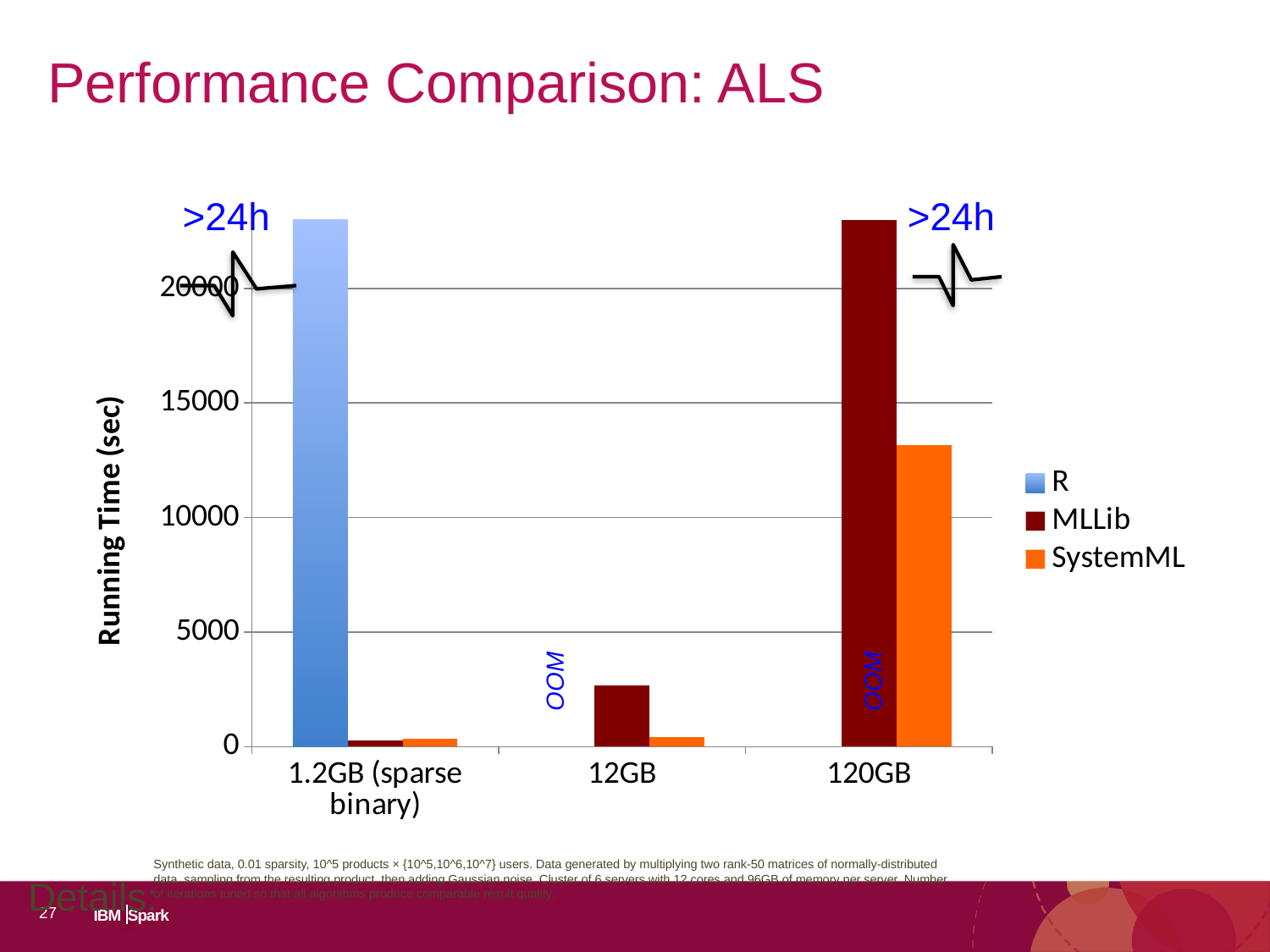
How many data-size categories are shown on the x axis? 3 Which series has the highest running time for the 1.2GB (sparse binary) dataset? R Is the SystemML running time for 120GB greater or less than 10000? greater Does the SystemML running time rise or fall as the dataset size increases from 1.2GB to 120GB? rise For the 12GB dataset, which has the larger running time, MLLib or SystemML? MLLib For the 120GB dataset, which has the larger running time, MLLib or SystemML? MLLib How many series does the legend list? 3 Is the SystemML running time for 120GB greater or less than 15000? less What are the three series listed in the legend? R, MLLib, SystemML What kind of chart is shown on the slide? bar chart What is the label of the y axis? Running Time (sec) Is the MLLib running time for 12GB greater or less than 5000? less